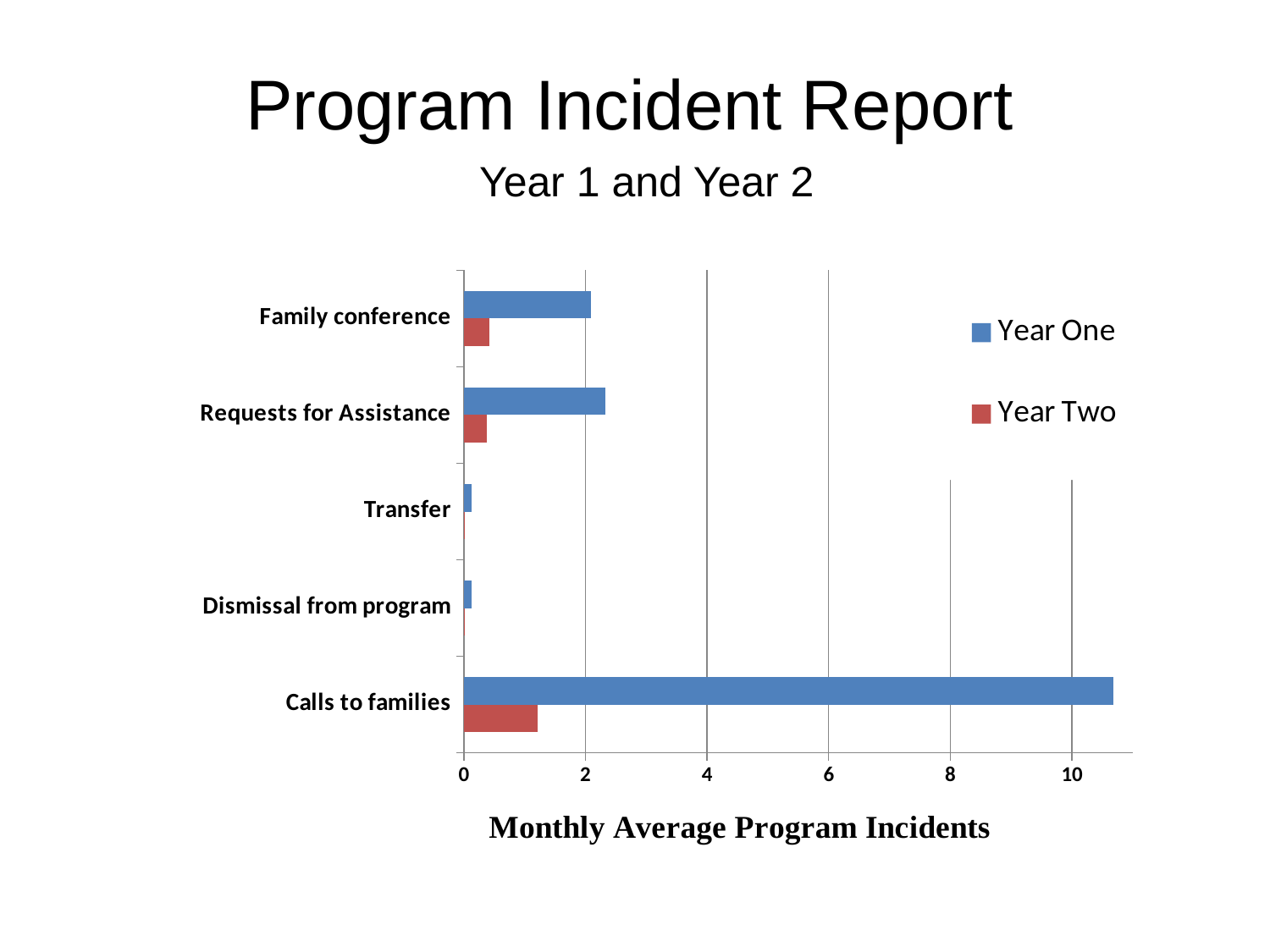
Which category has the highest Year Two value? Calls to families What kind of chart is shown on the slide? bar chart Is the Year Two value for Calls to families greater or less than 2? less What is the title of the horizontal axis? Monthly Average Program Incidents How many categories are plotted on the chart? 5 For Calls to families, which is larger: the Year One value or the Year Two value? Year One Is the Year One value for Transfer greater or less than 2? less Is the Year One value for Calls to families greater or less than 10? greater Which category has the highest Year One value? Calls to families How many series does the legend list? 2 Which is larger: the Year One value for Calls to families or the Year One value for Requests for Assistance? Calls to families